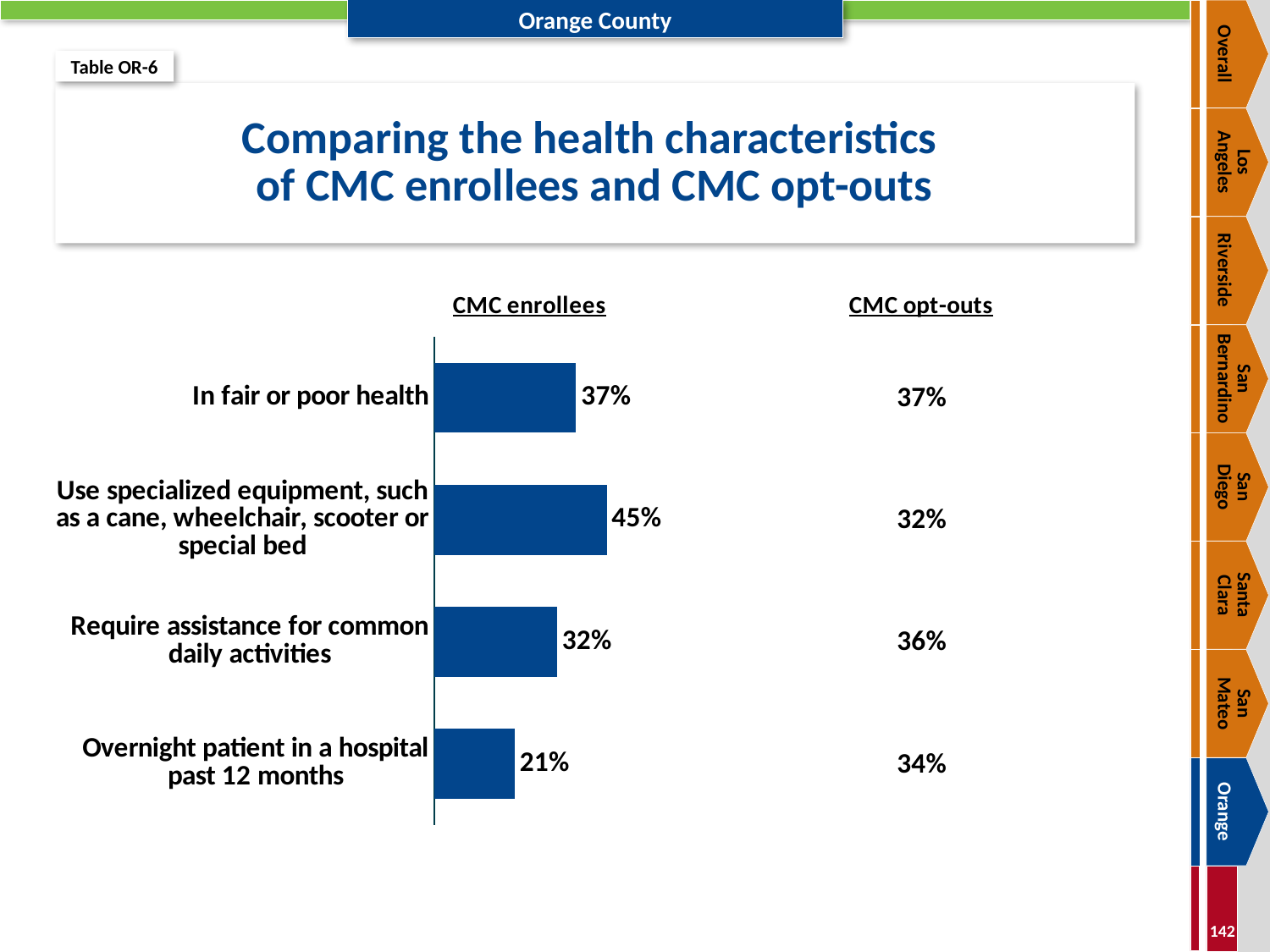
What is the title of the chart on the slide? Comparing the health characteristics of CMC enrollees and CMC opt-outs What percentage of CMC enrollees are in fair or poor health? 37% What percentage of CMC enrollees use specialized equipment, such as a cane, wheelchair, scooter or special bed? 45% What percentage of CMC enrollees were an overnight patient in a hospital in the past 12 months? 21% Which health characteristic has the lowest percentage among CMC enrollees? Overnight patient in a hospital past 12 months What type of chart is used to show the CMC enrollees values? Bar chart What percentage of CMC opt-outs require assistance for common daily activities? 36% What is the difference between the CMC enrollees and CMC opt-outs percentages for overnight patient in a hospital past 12 months? 13% How many health characteristics are shown in the chart? 4 Which health characteristic has the highest percentage among CMC enrollees? Use specialized equipment, such as a cane, wheelchair, scooter or special bed For use of specialized equipment, which group has the higher percentage, CMC enrollees or CMC opt-outs? CMC enrollees For requiring assistance for common daily activities, which group has the higher percentage, CMC enrollees or CMC opt-outs? CMC opt-outs